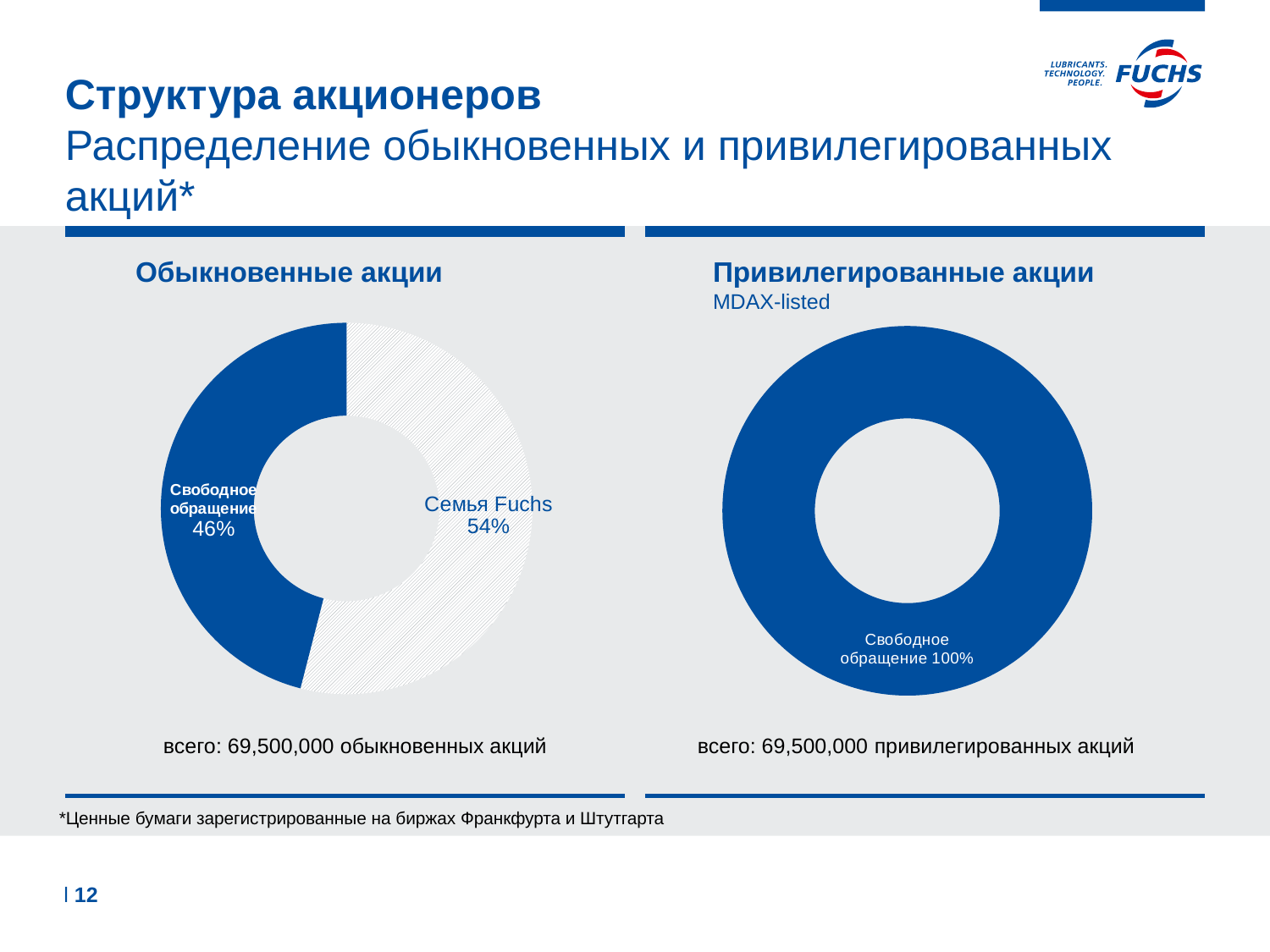
In the "Обыкновенные акции" chart, what share is held by Семья Fuchs? 54% In the "Привилегированные акции" chart, what share is in Свободное обращение? 100% What type of chart is used on the left side of the slide for "Обыкновенные акции"? Donut (pie) chart What total number of shares is stated below the "Обыкновенные акции" chart? 69,500,000 What index listing is noted under the "Привилегированные акции" chart title? MDAX-listed In the "Обыкновенные акции" chart, what share is in Свободное обращение? 46% How many segments does the "Привилегированные акции" chart have? 1 In the "Обыкновенные акции" chart, which segment is the largest? Семья Fuchs In the "Обыкновенные акции" chart, which is larger: the Семья Fuchs share or the Свободное обращение share? Семья Fuchs In the "Обыкновенные акции" chart, what is the difference in percentage points between the Семья Fuchs share and the Свободное обращение share? 8 percentage points How many segments does the "Обыкновенные акции" chart have? 2 In the "Обыкновенные акции" chart, which segment is the smallest? Свободное обращение